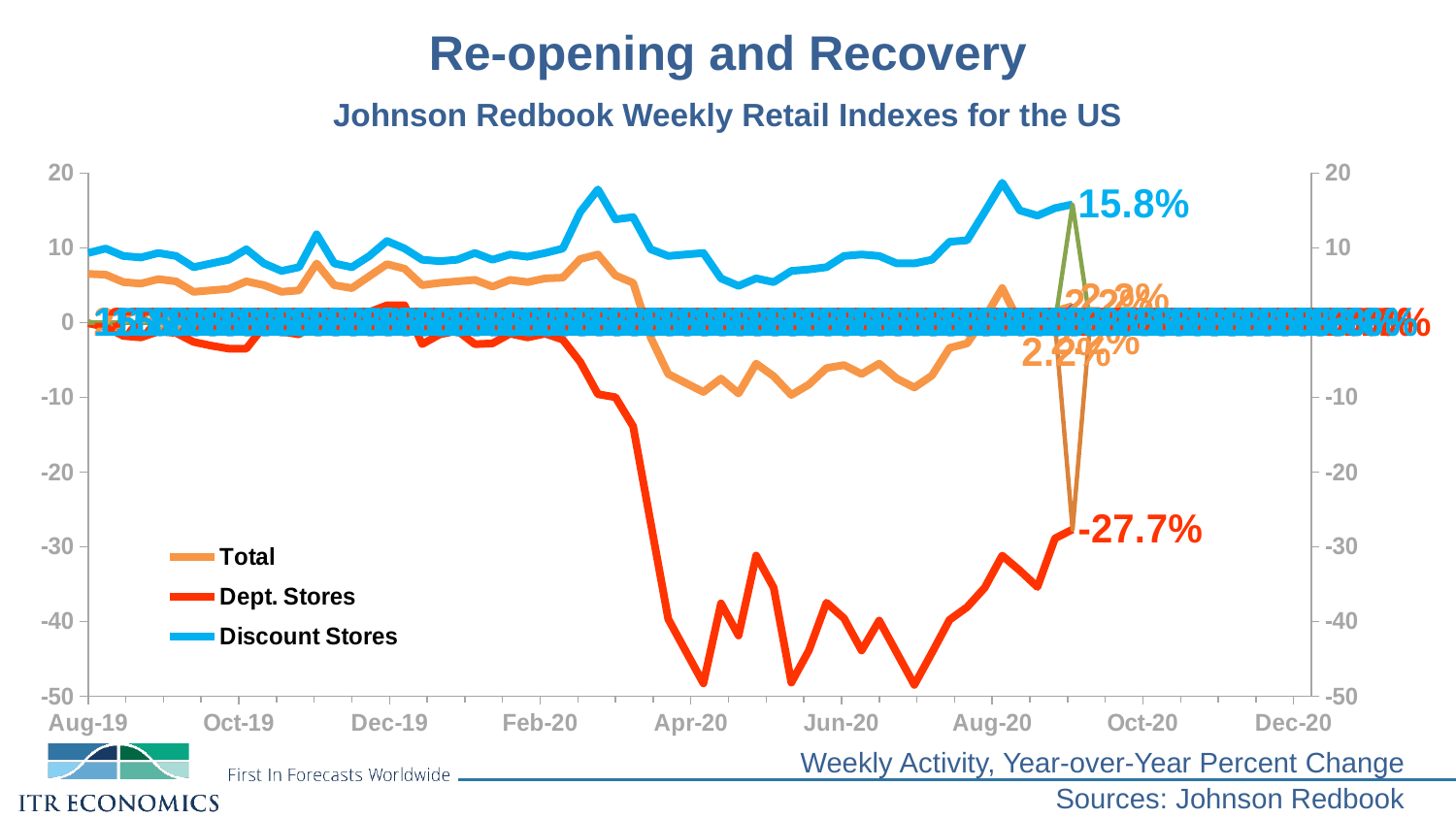
Is the value for Dept. Stores around Apr-20 greater or less than -40? less Which series has the lowest value at the end of the plotted data? Dept. Stores Which series has the highest value at the end of the plotted data? Discount Stores What is the title of the chart? Johnson Redbook Weekly Retail Indexes for the US What is the difference between the latest labelled Discount Stores value (15.8%) and the latest labelled Dept. Stores value (-27.7%)? 43.5% Is the value for Discount Stores around Aug-19 greater or less than 0? greater At the latest labelled point, which is larger: Discount Stores or Dept. Stores? Discount Stores What is the latest labelled value for Discount Stores? 15.8% How many series does the legend list? 3 Does the Dept. Stores line rise or fall between Feb-20 and Apr-20? fall What kind of chart is shown on the slide? line chart What is the latest labelled value for Dept. Stores? -27.7%